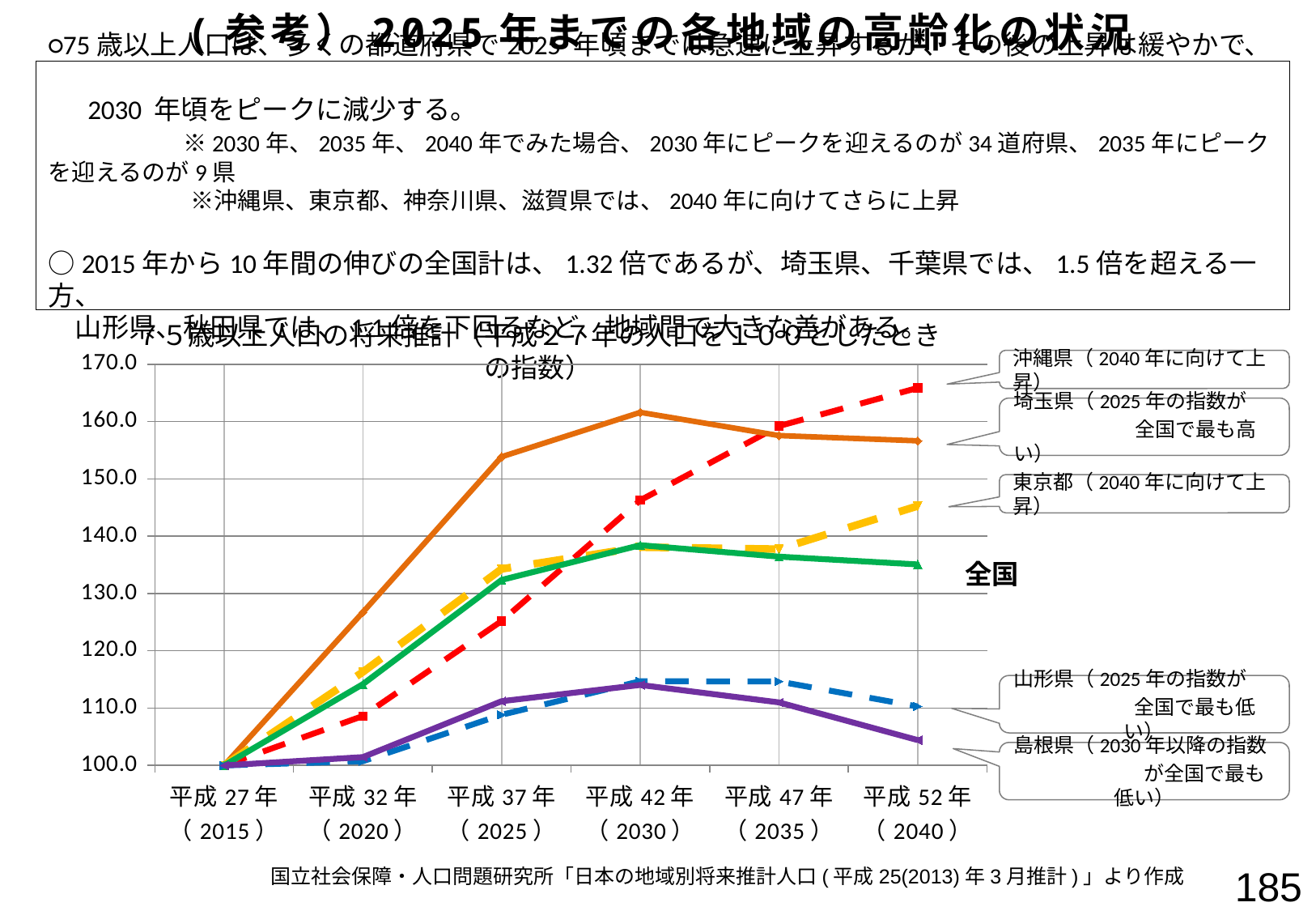
Which series has the highest value at 平成52年（2040）? 沖縄県 At 平成37年（2025）, which is larger: the value for 埼玉県 or the value for 沖縄県? 埼玉県 Is the value for 山形県 at 平成52年（2040） greater or less than 120? less Does the value for 島根県 rise or fall from 平成42年（2030） to 平成52年（2040）? fall Which series has the lowest value at 平成52年（2040）? 島根県 What kind of chart is shown on the slide? line chart How many series (regions) are labelled on the chart? 6 Is the value for 全国 at 平成42年（2030） greater or less than 130? greater Which series has the highest value at 平成42年（2030）? 埼玉県 Is the value for 埼玉県 at 平成37年（2025） greater or less than 150? greater Which series is drawn as the solid green line? 全国 How many points are plotted along the x axis of the chart? 6